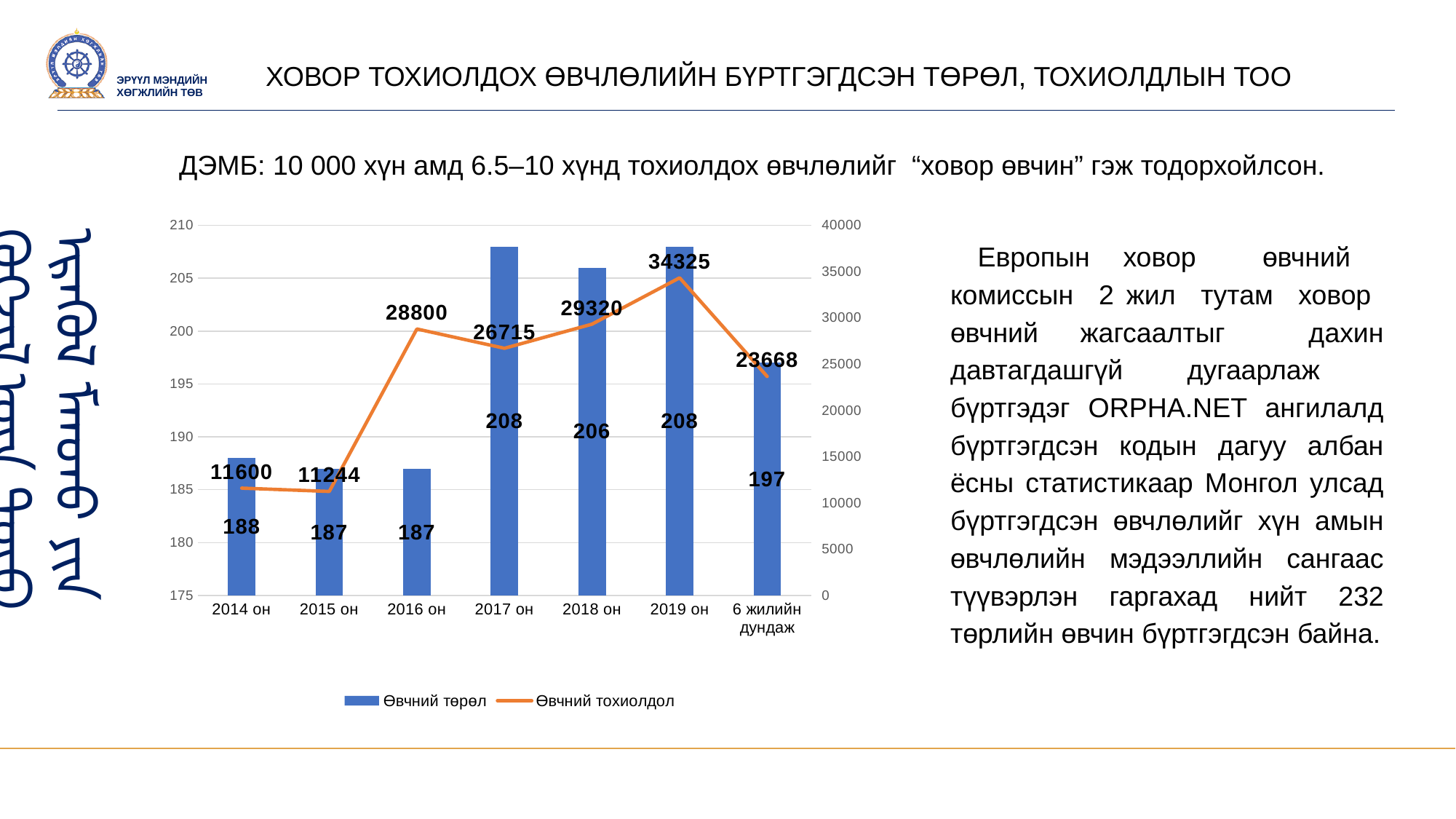
Which category has the lowest value of Өвчний тохиолдол? 2015 он What is the value of Өвчний тохиолдол for 2016 он? 28800 Which is larger, the Өвчний тохиолдол value for 2016 он or for 2017 он? 2016 он What is the value of Өвчний төрөл for 2017 он? 208 What is the difference between the Өвчний төрөл values for 2017 он and 2014 он? 20 Which category has the highest value of Өвчний тохиолдол? 2019 он What is the value of Өвчний төрөл for 6 жилийн дундаж? 197 How many categories are shown on the x axis? 7 What is the difference between the Өвчний тохиолдол values for 2019 он and 2018 он? 5005 How many series does the legend list? 2 What is the value of Өвчний тохиолдол for 2019 он? 34325 What kind of chart is shown on the slide? Combined bar and line chart